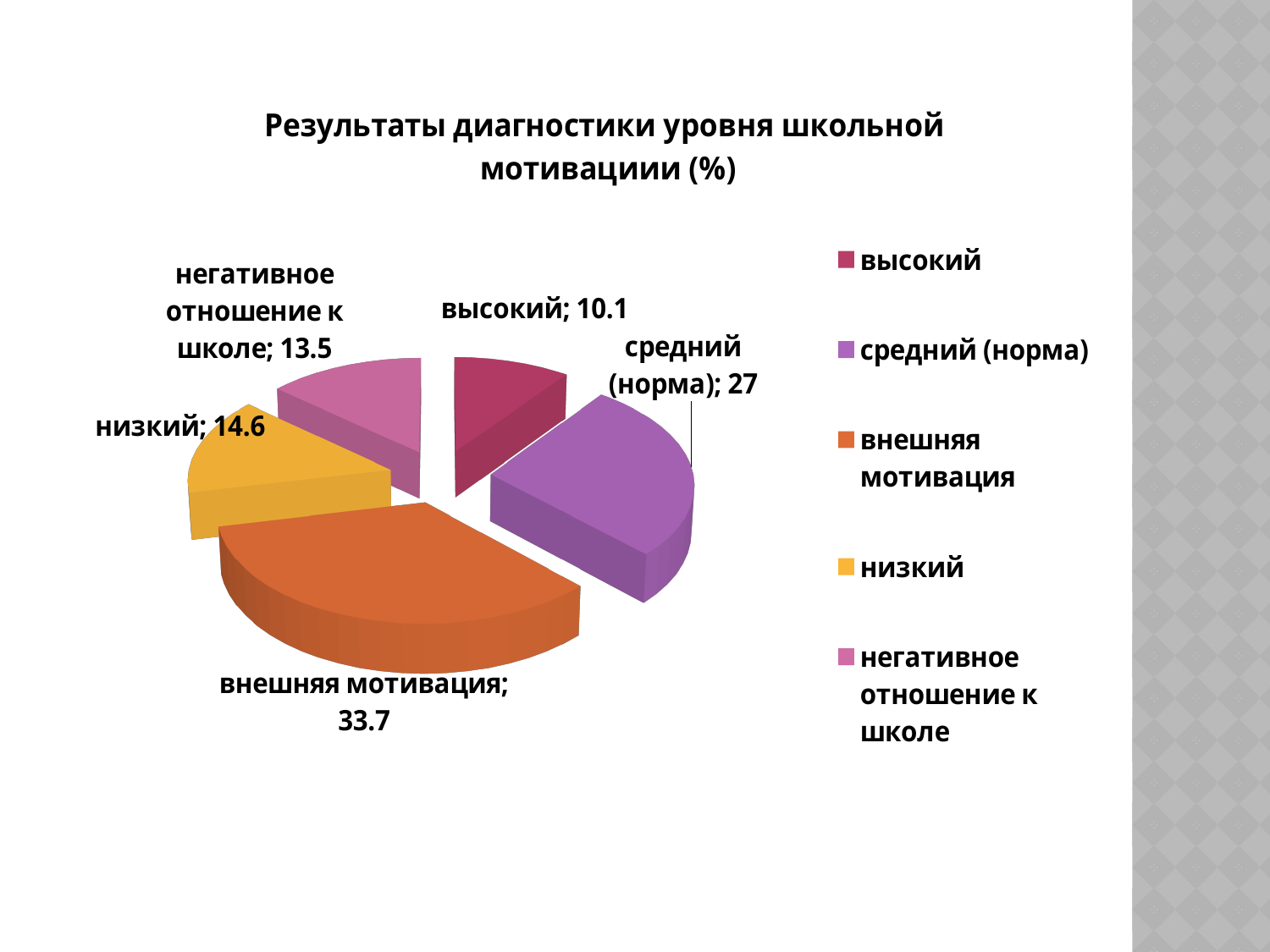
How many categories does the pie chart have? 5 What type of chart is shown on the slide? pie chart What is the value for "средний (норма)"? 27 What is the value for "низкий"? 14.6 Which category has the smallest slice? высокий What is the value for "высокий"? 10.1 Which category has the largest slice? внешняя мотивация What is the title of the chart? Результаты диагностики уровня школьной мотивациии (%) What is the value for "внешняя мотивация"? 33.7 Which is larger, the value for "низкий" or the value for "негативное отношение к школе"? низкий What is the difference between the values for "внешняя мотивация" and "средний (норма)"? 6.7 What is the value for "негативное отношение к школе"? 13.5